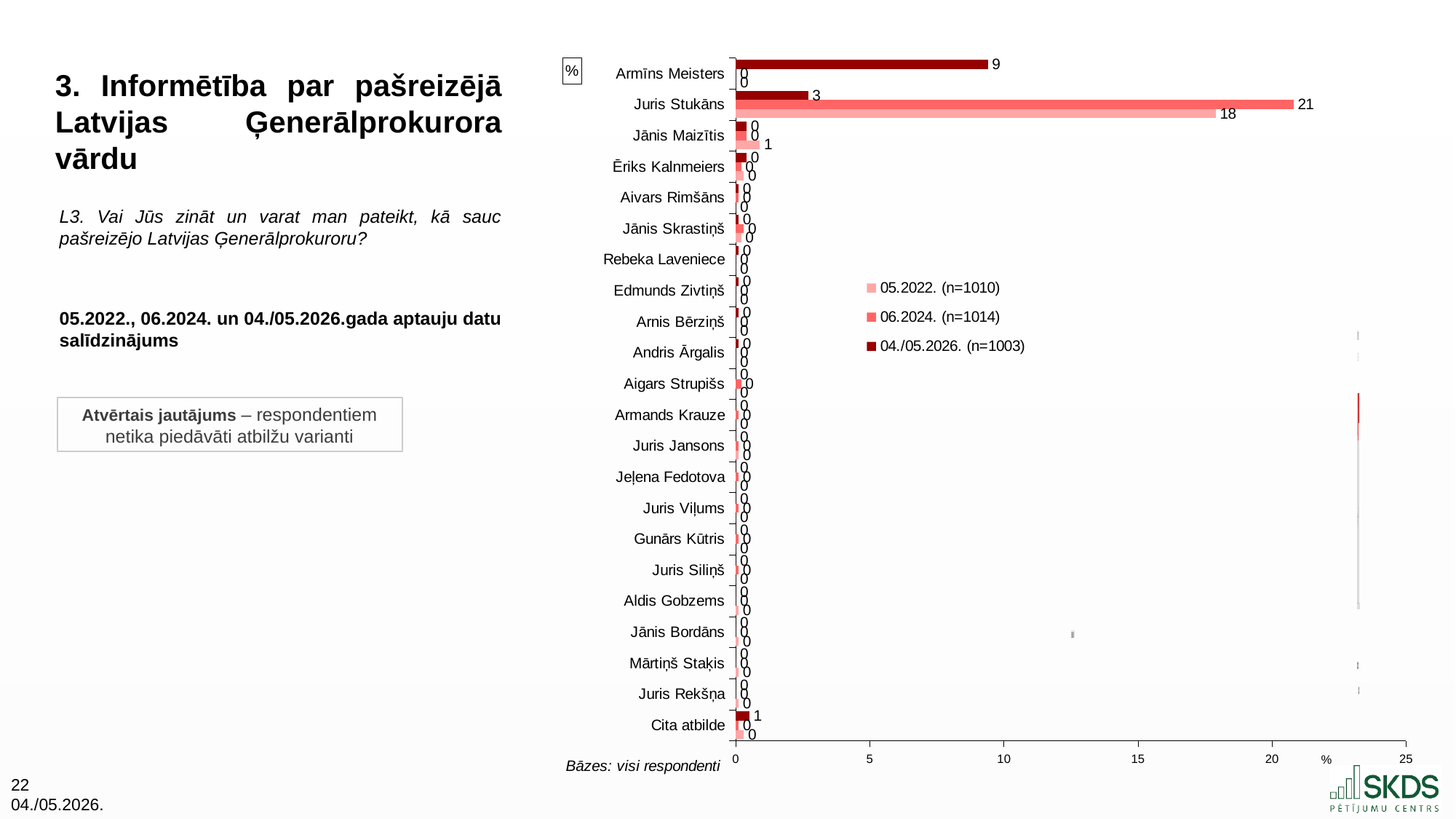
What is the value for Jānis Maizītis in the 05.2022. series? 1 What is the sample size (n) shown in the legend for the 04./05.2026. series? n=1003 What is the value for Juris Stukāns in the 06.2024. series? 21 How many series does the legend list? 3 What is the difference between the 06.2024. and 05.2022. values for Juris Stukāns? 3 Which category has the highest value in the 04./05.2026. series? Armīns Meisters What is the value for Juris Stukāns in the 04./05.2026. series? 3 Which is larger for Juris Stukāns: the 06.2024. value or the 04./05.2026. value? 06.2024. What is the value for Juris Stukāns in the 05.2022. series? 18 Which category has the highest value in the 06.2024. series? Juris Stukāns What kind of chart is shown on the slide? Bar chart What is the value for Armīns Meisters in the 04./05.2026. series? 9